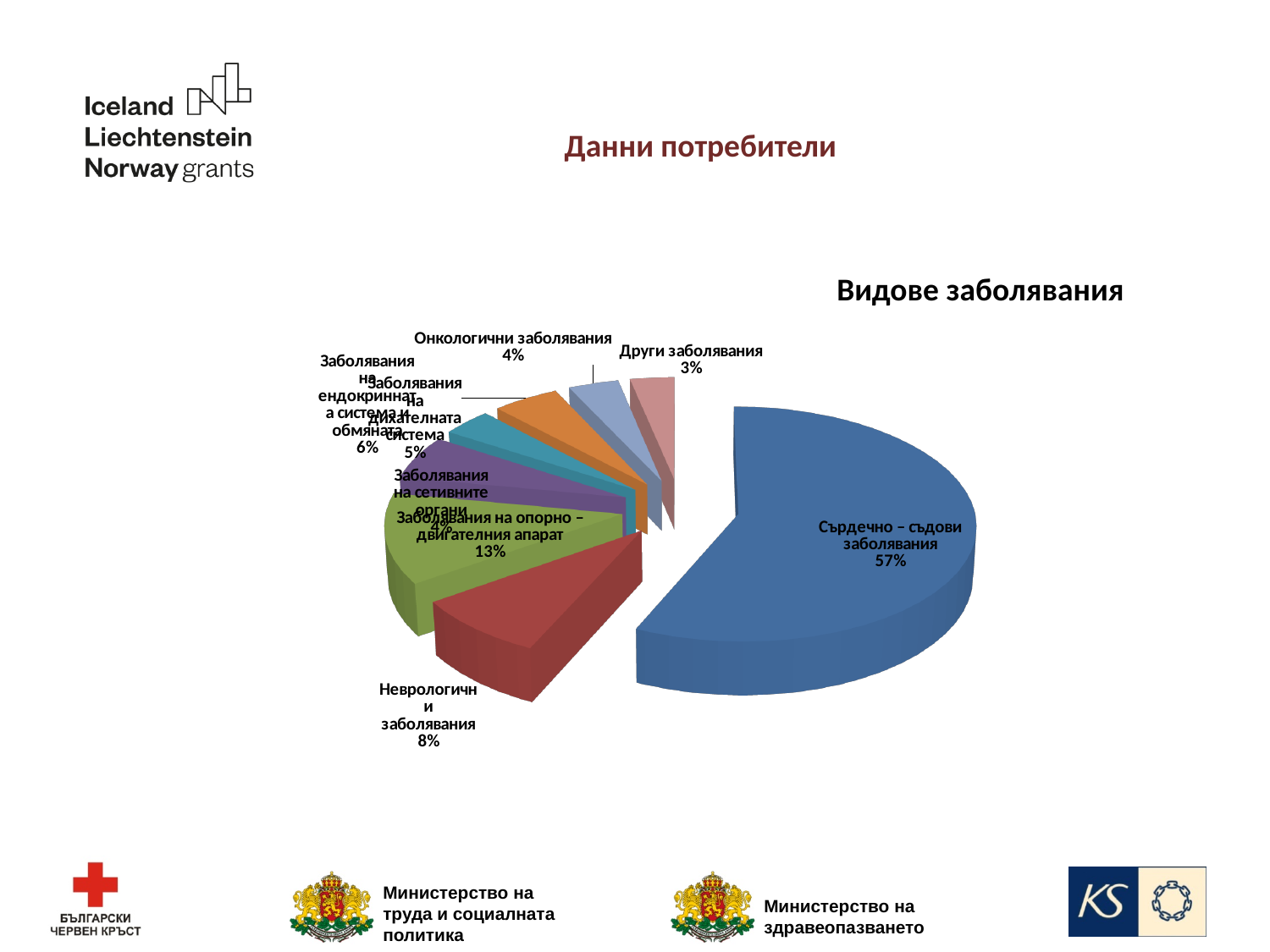
What percentage is shown for Заболявания на опорно – двигателния апарат? 13% What percentage is shown for Неврологични заболявания? 8% What share of the pie is Сърдечно – съдови заболявания? 57% How many slices does the pie chart have? 8 What percentage is shown for Онкологични заболявания? 4% Which is larger, the share for Неврологични заболявания or the share for Заболявания на дихателната система? Неврологични заболявания What percentage is shown for Други заболявания? 3% What is the difference in percentage points between Сърдечно – съдови заболявания and Заболявания на опорно – двигателния апарат? 44 Which category has the smallest share of the pie? Други заболявания What type of chart is shown on the slide? pie chart What is the title of the chart? Видове заболявания Which category has the largest share of the pie? Сърдечно – съдови заболявания